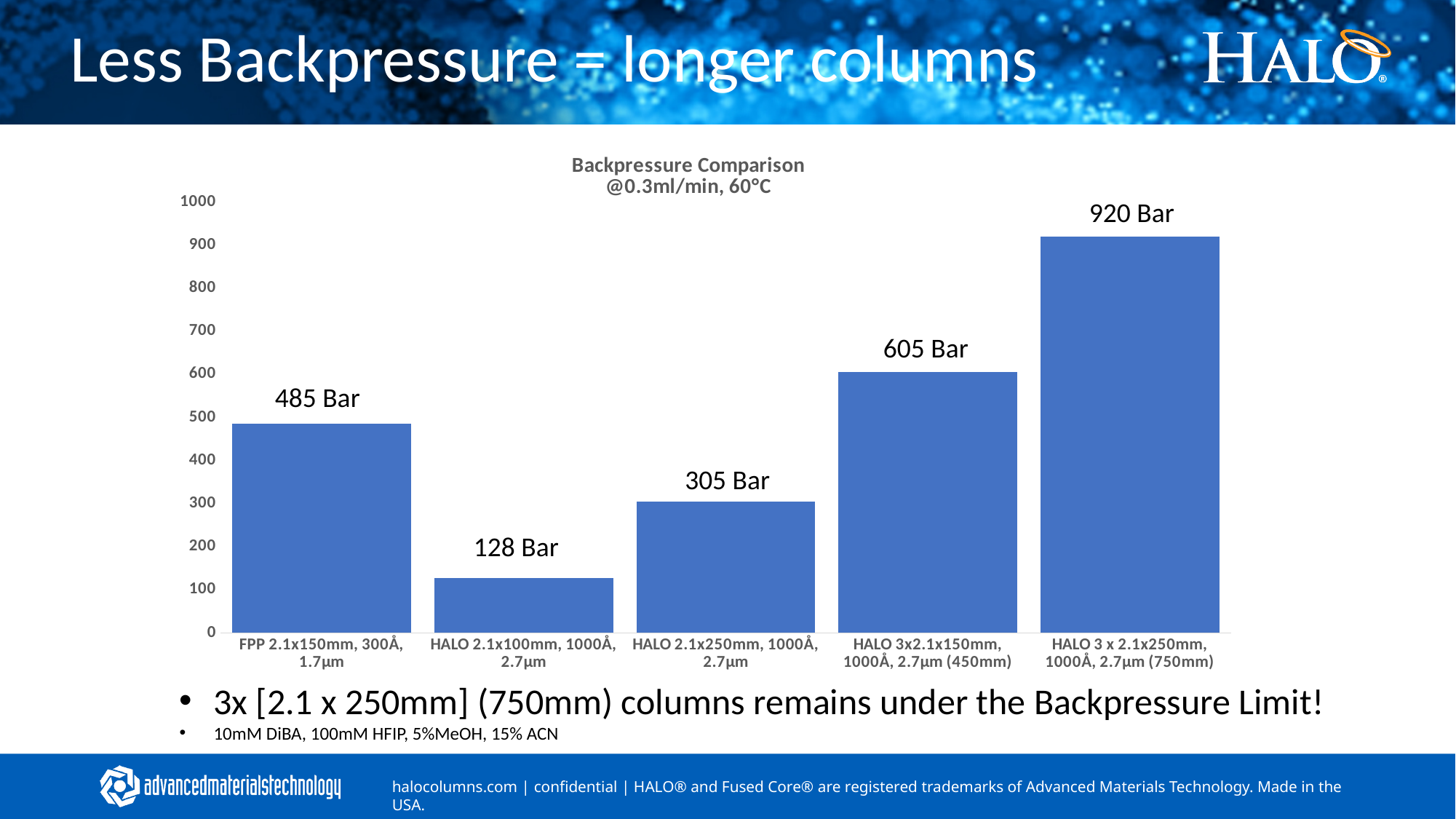
What is the title of the chart? Backpressure Comparison @0.3ml/min, 60°C Which column configuration has the highest backpressure? HALO 3 x 2.1x250mm, 1000Å, 2.7µm (750mm) How many column configurations are shown in the chart? 5 What is the backpressure value for the HALO 2.1x100mm, 1000Å, 2.7µm column? 128 Bar Which has a higher backpressure: the FPP 2.1x150mm, 300Å, 1.7µm column or the HALO 2.1x250mm, 1000Å, 2.7µm column? FPP 2.1x150mm, 300Å, 1.7µm What is the difference in backpressure between the HALO 3x2.1x150mm (450mm) column and the HALO 2.1x250mm column? 300 Bar What type of chart is shown on the slide? Bar chart What is the backpressure value for the FPP 2.1x150mm, 300Å, 1.7µm column? 485 Bar Is the backpressure for the HALO 3x2.1x150mm, 1000Å, 2.7µm (450mm) column greater or less than 500? greater What is the backpressure value for the HALO 3 x 2.1x250mm, 1000Å, 2.7µm (750mm) column? 920 Bar What is the difference in backpressure between the FPP 2.1x150mm column and the HALO 2.1x100mm column? 357 Bar Which column configuration has the lowest backpressure? HALO 2.1x100mm, 1000Å, 2.7µm